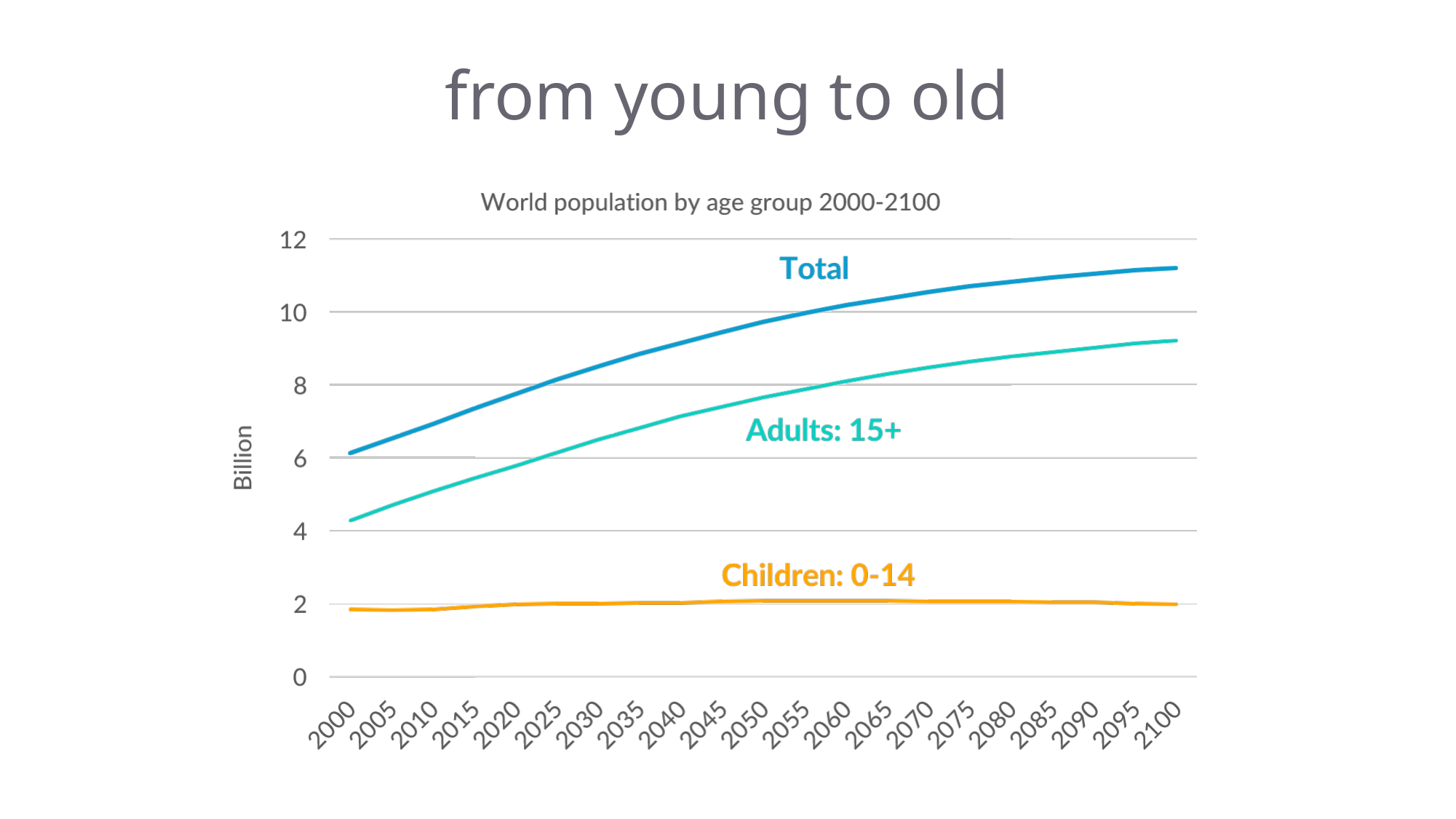
What is the title of the chart? World population by age group 2000-2100 Which series has the lowest value across the whole chart? Children: 0-14 Is the value for Adults: 15+ in 2100 greater or less than 10? less Does the Adults: 15+ line rise or fall from 2000 to 2100? rise Is the value for Total in 2100 greater or less than 10? greater Does the Total line rise or fall from 2000 to 2100? rise What kind of chart is shown on the slide? line chart What is the label on the vertical axis of the chart? Billion How many years are labelled along the x axis of the chart? 21 Is the value for Children: 0-14 in 2050 greater or less than 4? less Which series has the highest value in 2100? Total How many series are plotted on the chart? 3